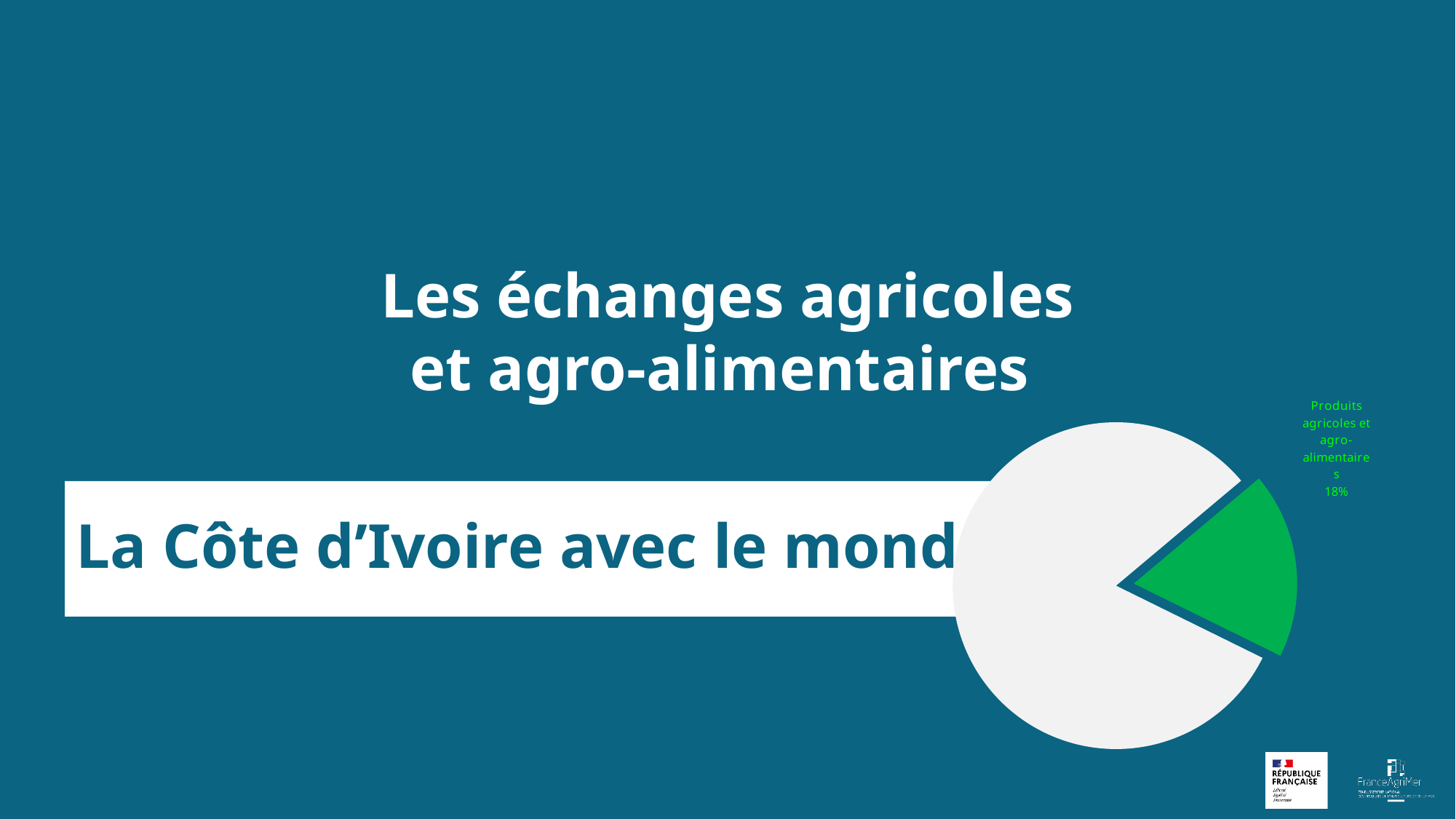
Which slice of the pie chart is larger, the green "Produits agricoles et agro-alimentaires" slice or the unlabelled grey slice? the unlabelled grey slice What share of the pie does the slice labelled "Produits agricoles et agro-alimentaires" represent? 18% How many slices does the pie chart have? 2 What is the value printed for the green slice of the pie chart? 18% Which slice of the pie chart is the smallest? Produits agricoles et agro-alimentaires What kind of chart is shown on the slide? pie chart What colour is the slice labelled "Produits agricoles et agro-alimentaires" in the pie chart? green